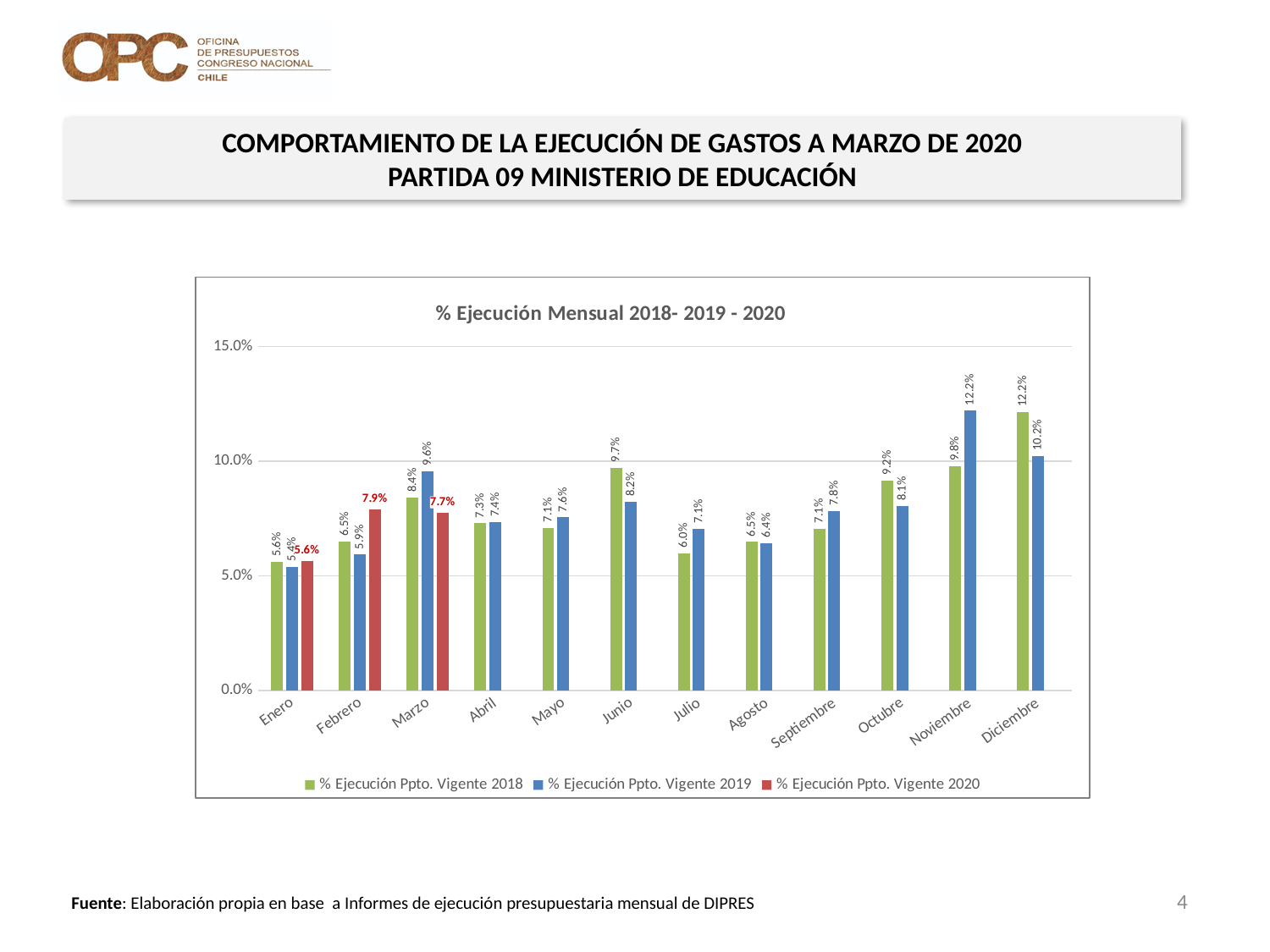
How many months are shown on the x axis? 12 Which month has the highest value for % Ejecución Ppto. Vigente 2018? Diciembre What kind of chart is shown on the slide? Bar chart Which month has the lowest value for % Ejecución Ppto. Vigente 2019? Enero How many series does the legend list? 3 What is the value for % Ejecución Ppto. Vigente 2020 in Febrero? 7.9% Is the value for % Ejecución Ppto. Vigente 2019 in Diciembre greater or less than 10.0%? greater What is the value for % Ejecución Ppto. Vigente 2020 in Marzo? 7.7% What is the value for % Ejecución Ppto. Vigente 2019 in Noviembre? 12.2% In Febrero, which series has the larger value: % Ejecución Ppto. Vigente 2018 or % Ejecución Ppto. Vigente 2020? % Ejecución Ppto. Vigente 2020 What is the difference between the 2019 and 2020 values in Marzo? 1.9% What is the value for % Ejecución Ppto. Vigente 2018 in Junio? 9.7%